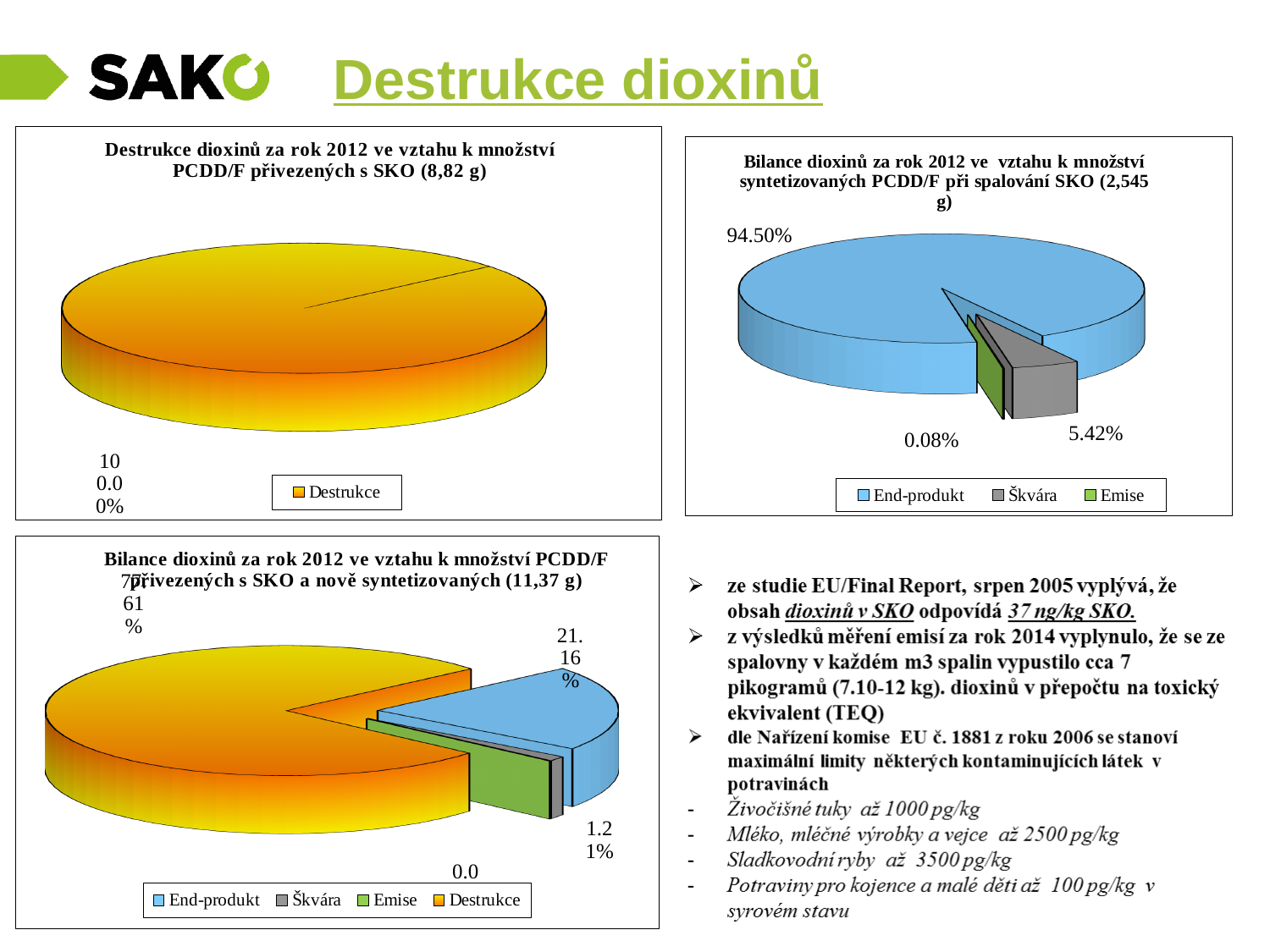
In the bottom-left chart (Bilance dioxinů ... přivezených s SKO a nově syntetizovaných), how many entries does the legend list? 4 In the top-right chart (Bilance dioxinů ... syntetizovaných PCDD/F), what share does Škvára have? 5.42% In the top-left chart (Destrukce dioxinů za rok 2012), what share does Destrukce have? 100.00% In the bottom-left chart (Bilance dioxinů ... přivezených s SKO a nově syntetizovaných), what share does End-produkt have? 21.16% In the top-right chart (Bilance dioxinů ... syntetizovaných PCDD/F), how many entries does the legend list? 3 In the top-right chart (Bilance dioxinů ... syntetizovaných PCDD/F), what share does End-produkt have? 94.50% In the bottom-left chart (Bilance dioxinů ... přivezených s SKO a nově syntetizovaných), which category has the largest slice? Destrukce In the top-right chart (Bilance dioxinů ... syntetizovaných PCDD/F), which category has the largest slice? End-produkt In the top-right chart (Bilance dioxinů ... syntetizovaných PCDD/F), what is the difference between the End-produkt and Škvára shares? 89.08% What kind of chart is the top-left chart (Destrukce dioxinů za rok 2012)? Pie chart In the top-right chart (Bilance dioxinů ... syntetizovaných PCDD/F), what share does Emise have? 0.08%